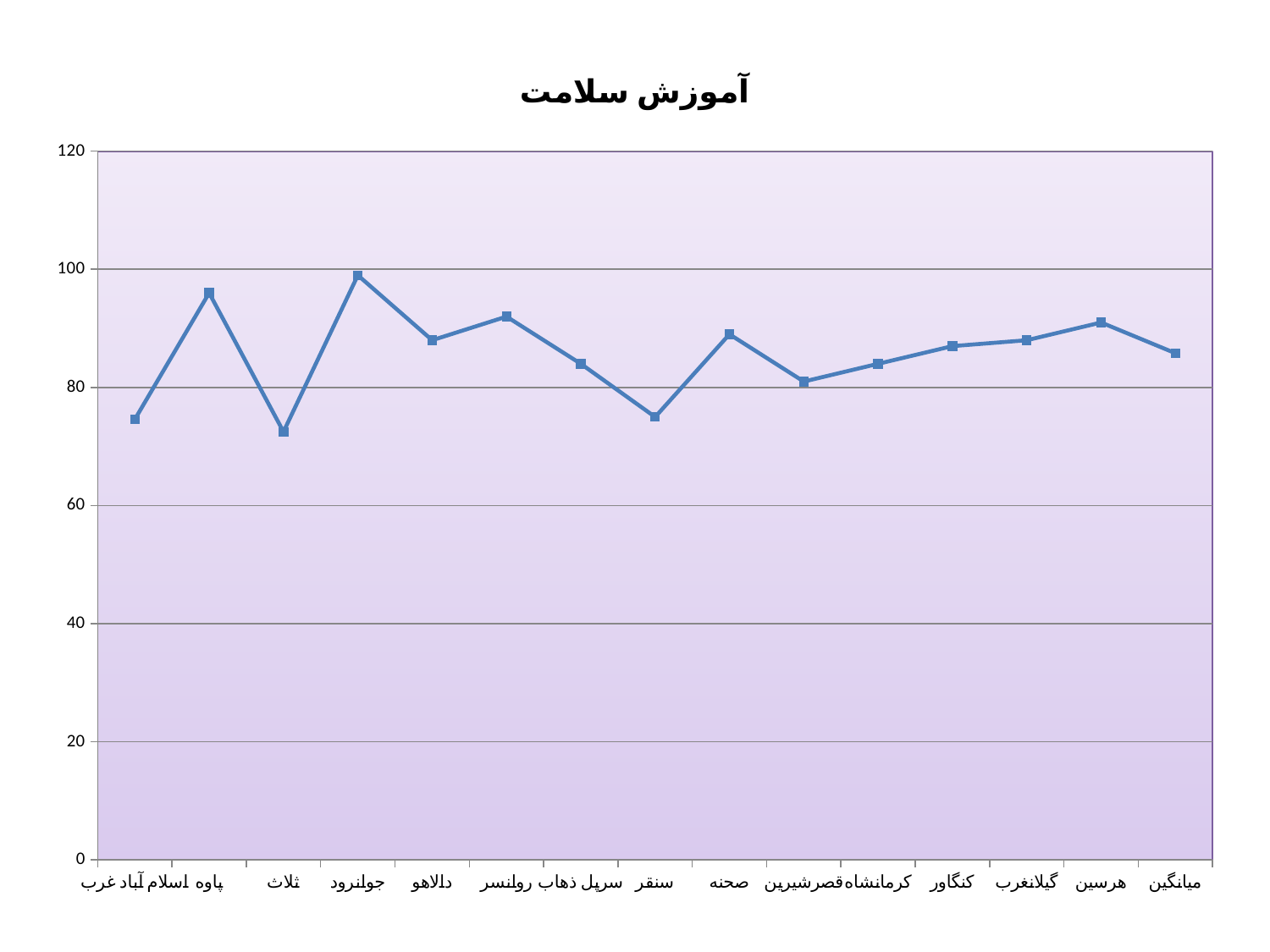
Is the value for روانسر greater or less than 80? greater Which has the larger value, روانسر or سنقر? روانسر What is the title of the chart? آموزش سلامت Which category has the lowest value? ثلاث Is the value for سنقر greater or less than 80? less Which has the larger value, پاوه or ثلاث? پاوه What kind of chart is shown on the slide? line chart Is the value for پاوه greater or less than 80? greater How many categories are plotted along the x axis? 15 Which category has the highest value? جوانرود